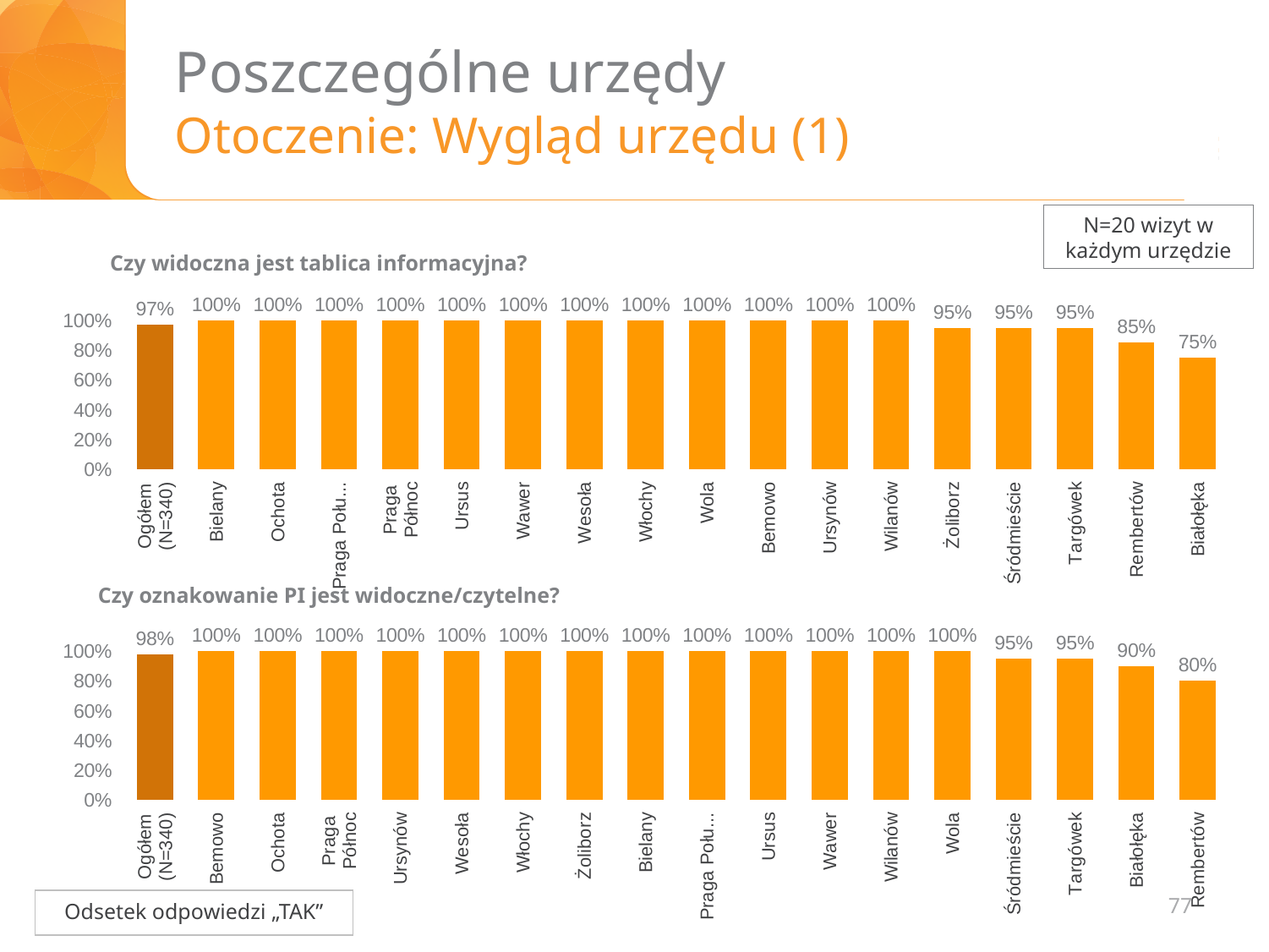
In the chart 'Czy oznakowanie PI jest widoczne/czytelne?', which is larger: Białołęka or Rembertów? Białołęka What type of chart is the bottom chart on the slide? Bar chart In the chart 'Czy widoczna jest tablica informacyjna?', is the value for Rembertów greater or less than 80%? greater In the chart 'Czy widoczna jest tablica informacyjna?', how many bars are shown? 18 In the chart 'Czy oznakowanie PI jest widoczne/czytelne?', what is the value for Rembertów? 80% In the chart 'Czy oznakowanie PI jest widoczne/czytelne?', what is the value for Ogółem (N=340)? 98% In the chart 'Czy oznakowanie PI jest widoczne/czytelne?', what is the difference between Śródmieście and Białołęka? 5% In the chart 'Czy widoczna jest tablica informacyjna?', which category has the lowest value? Białołęka In the chart 'Czy oznakowanie PI jest widoczne/czytelne?', which category has the lowest value? Rembertów In the chart 'Czy widoczna jest tablica informacyjna?', what is the difference between Rembertów and Białołęka? 10% In the chart 'Czy widoczna jest tablica informacyjna?', what is the value for Ogółem (N=340)? 97% In the chart 'Czy widoczna jest tablica informacyjna?', what is the value for Białołęka? 75%